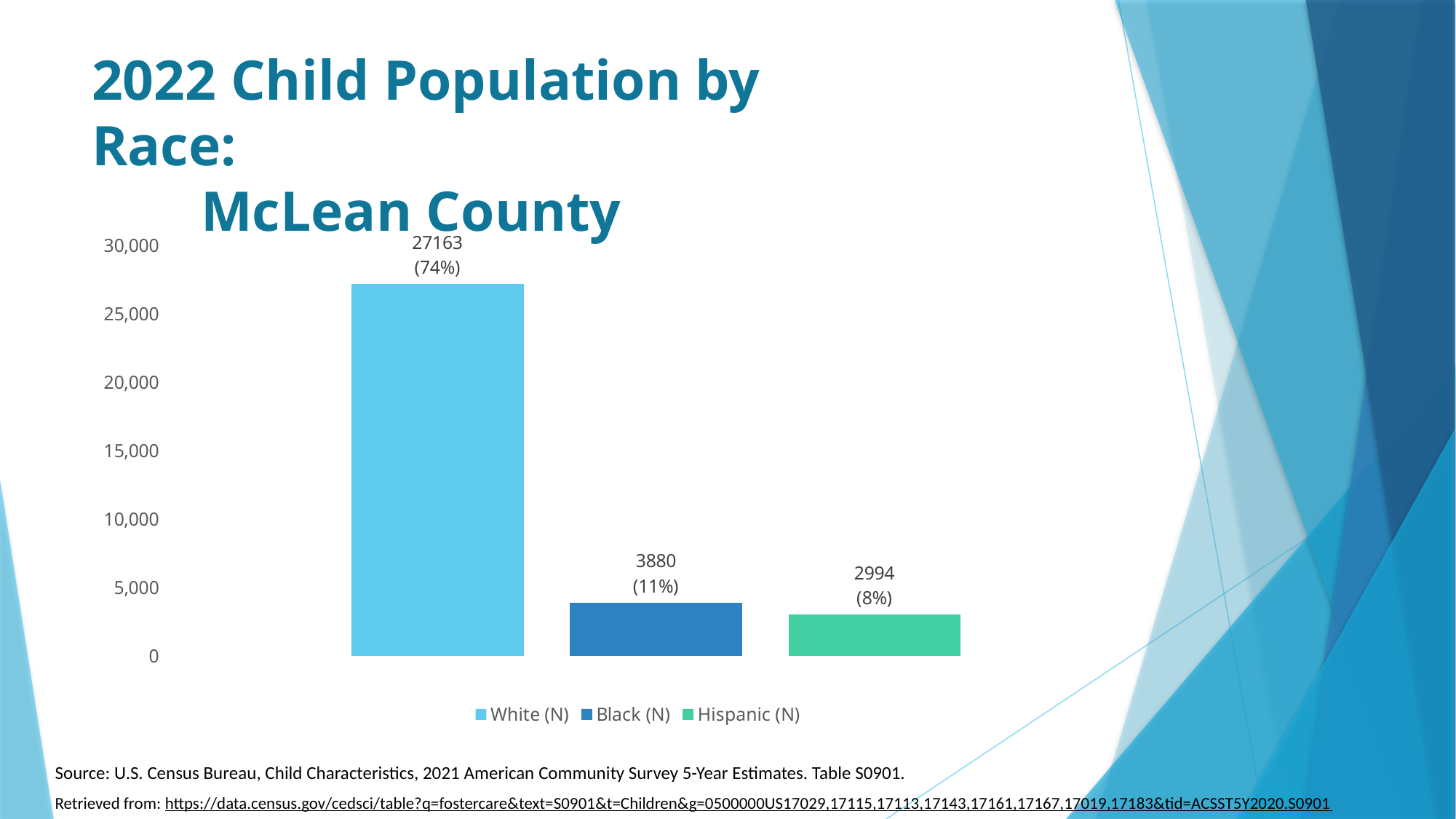
What is the difference between the White (N) and Black (N) values? 23283 Which category has the lowest value? Hispanic (N) What is the difference between the Black (N) and Hispanic (N) values? 886 How many series does the legend list? 3 What is the value for Hispanic (N)? 2994 What is the value for White (N)? 27163 What percentage is shown for the Black (N) bar? 11% Is the value for White (N) greater or less than 25,000? greater Which category has the highest value? White (N) Which is larger, the value for Black (N) or Hispanic (N)? Black (N) What is the value for Black (N)? 3880 What kind of chart is shown on the slide? bar chart